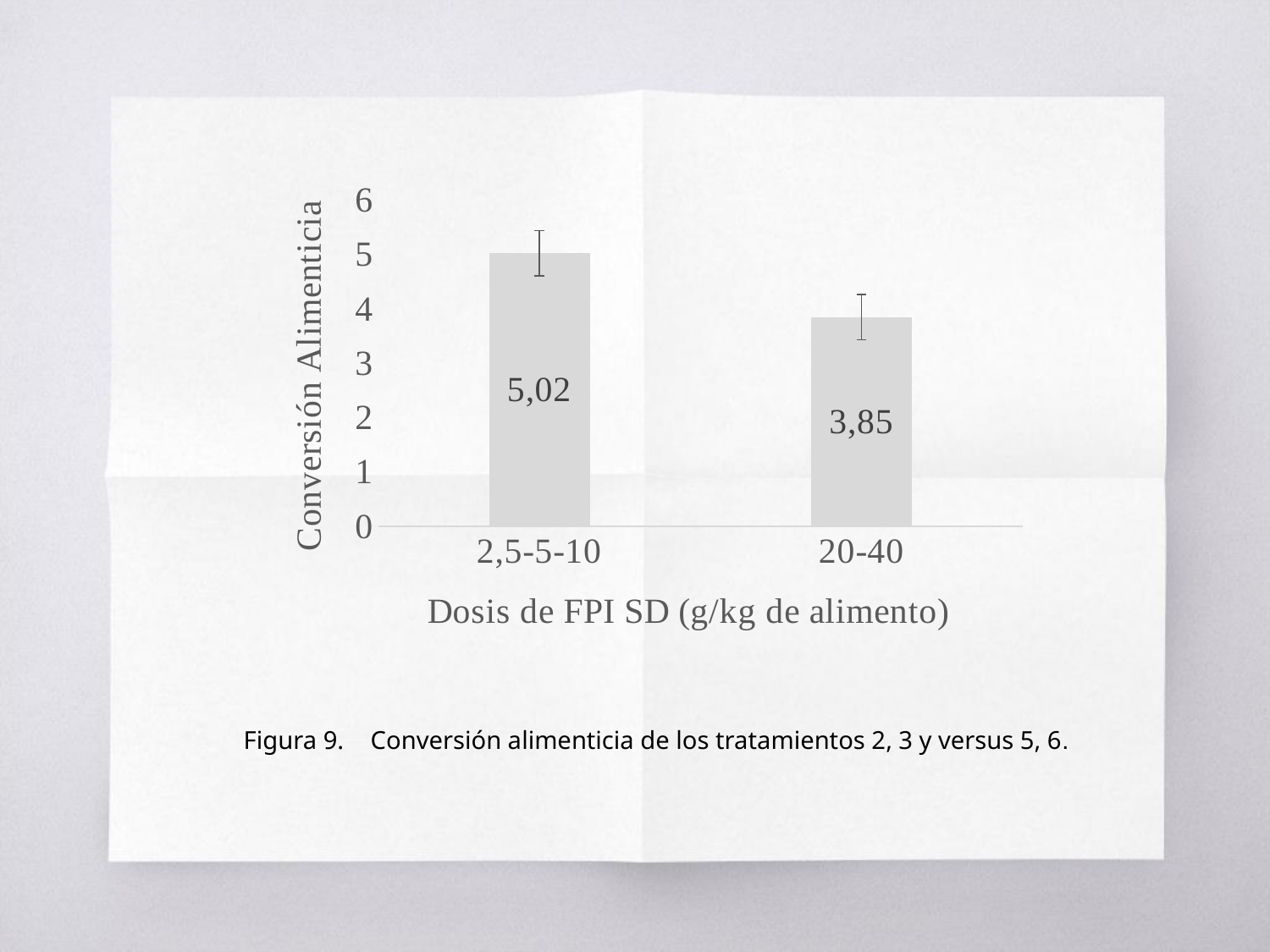
Which dose has a larger Conversión Alimenticia, 2,5-5-10 or 20-40? 2,5-5-10 How many dose categories are shown on the x axis? 2 What is the Conversión Alimenticia value for the 2,5-5-10 dose? 5,02 What is the label of the x axis of the chart? Dosis de FPI SD (g/kg de alimento) Which dose has the lowest Conversión Alimenticia? 20-40 What is the difference in Conversión Alimenticia between the 2,5-5-10 dose and the 20-40 dose? 1,17 Do the values rise or fall from the 2,5-5-10 dose to the 20-40 dose? fall What is the Conversión Alimenticia value for the 20-40 dose? 3,85 What kind of chart is shown on the slide? bar chart Is the Conversión Alimenticia for the 2,5-5-10 dose greater or less than 5? greater Which dose has the highest Conversión Alimenticia? 2,5-5-10 Is the Conversión Alimenticia for the 20-40 dose greater or less than 4? less